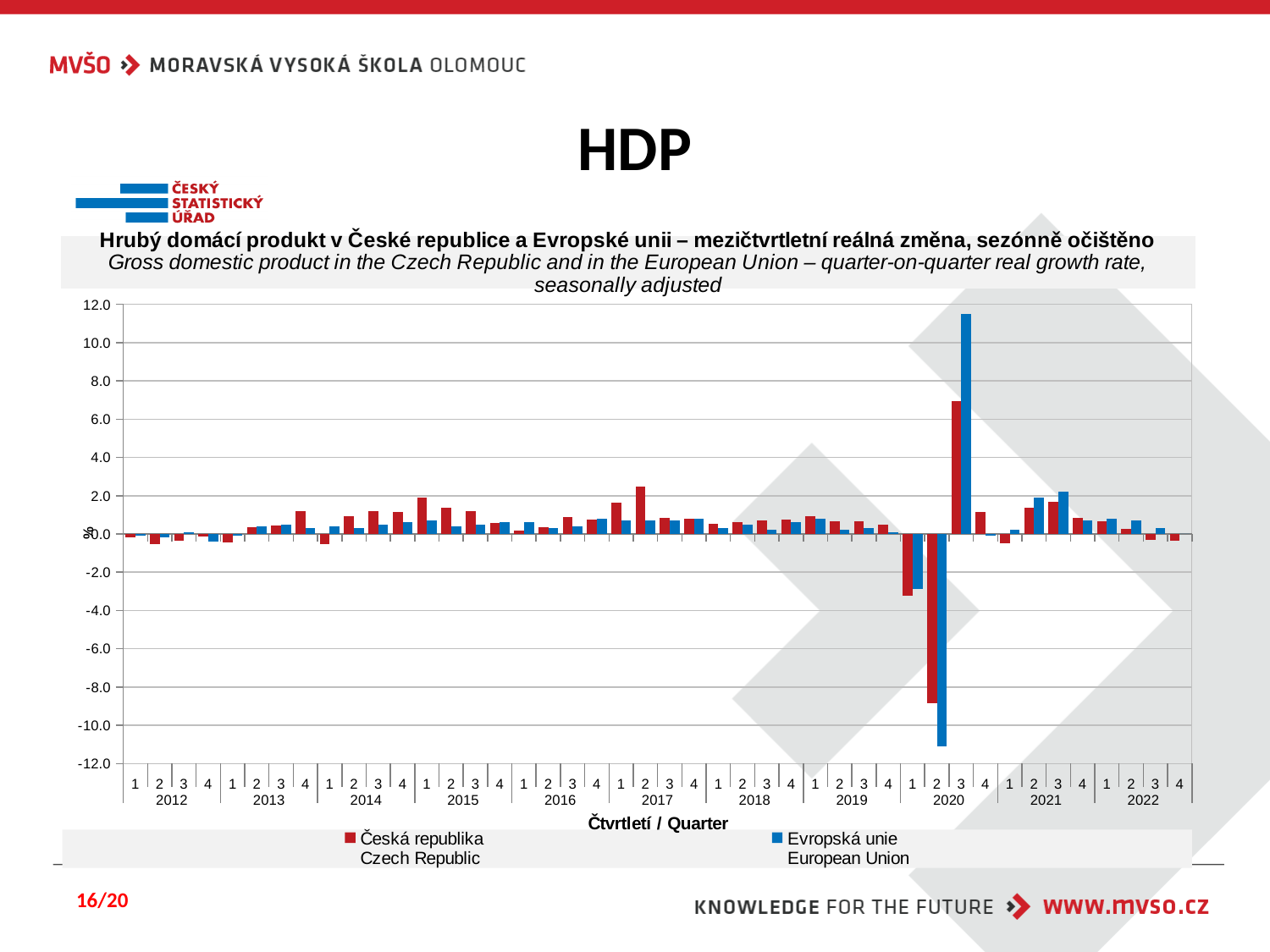
How many years are labelled on the x axis? 11 Which two series are shown in the legend? Česká republika / Czech Republic and Evropská unie / European Union What is the x-axis title of the chart? Čtvrtletí / Quarter In Q3 2020, which series has the larger value, Czech Republic or European Union? European Union Is the European Union value for Q3 2020 greater or less than 10.0? greater In which quarter does the Czech Republic series reach its lowest value? Q2 2020 In Q2 2017, which series has the larger value, Czech Republic or European Union? Czech Republic How many series does the legend list? 2 Is the European Union value for Q2 2020 greater or less than -10.0? less In which quarter does the European Union series reach its highest value? Q3 2020 Is the Czech Republic value for Q2 2020 greater or less than -8.0? less What kind of chart is shown on the slide? bar chart